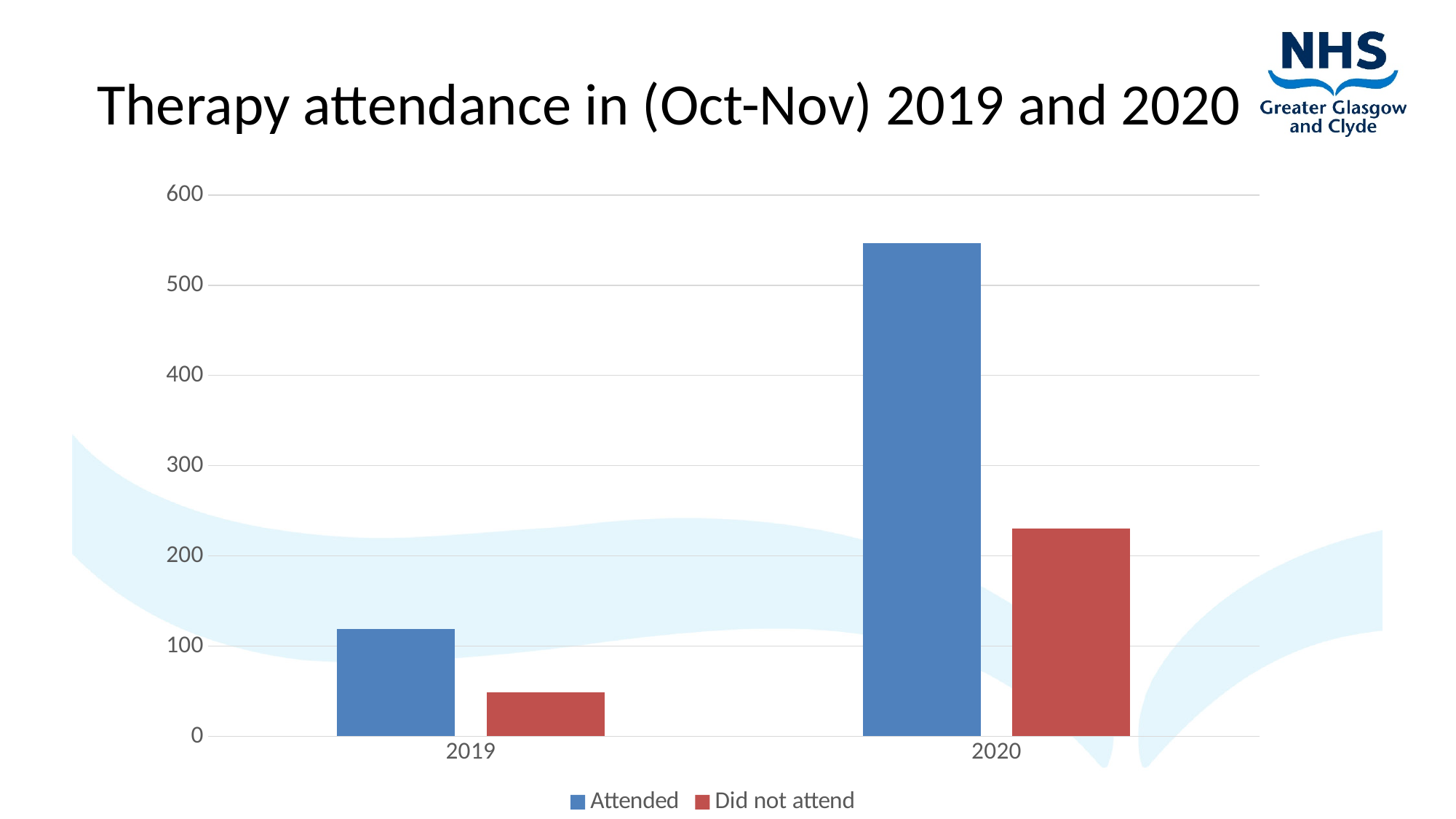
Is the value for Attended in 2020 greater or less than 500? greater Which is larger: Attended in 2019 or Attended in 2020? Attended in 2020 How many year categories are shown on the x axis? 2 Does the Attended series rise or fall from 2019 to 2020? Rise Which colour represents the 'Did not attend' series? Red How many series does the legend list? 2 Is the value for Did not attend in 2019 greater or less than 100? less What is the title of the chart? Therapy attendance in (Oct-Nov) 2019 and 2020 Which year and series has the tallest bar? Attended in 2020 Which year and series has the shortest bar? Did not attend in 2019 What kind of chart is shown on the slide? Bar chart Is the value for Did not attend in 2020 greater or less than 200? greater